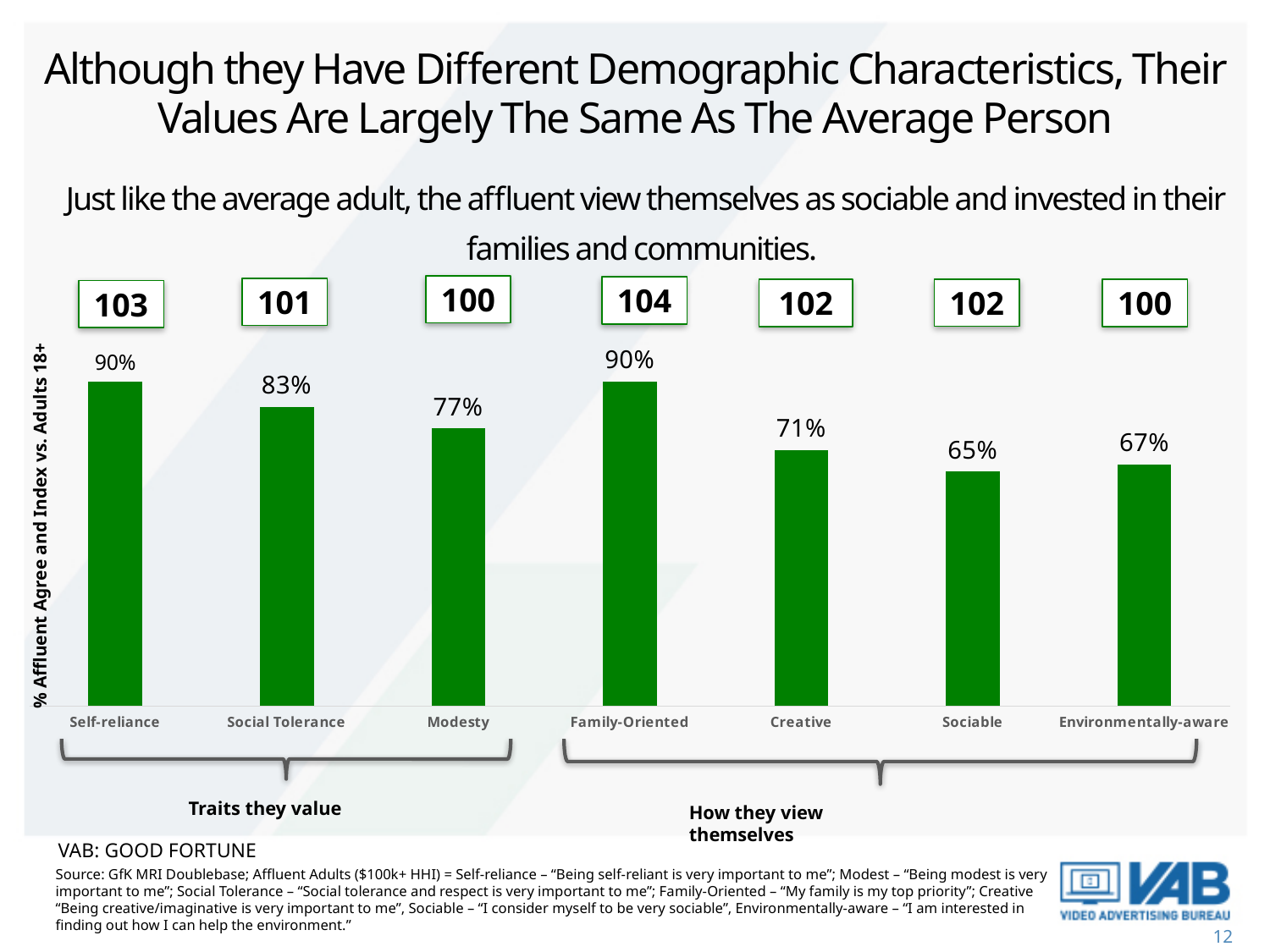
What percentage of affluent adults agree with the Self-reliance statement? 90% Which category has the lowest percentage of affluent adults agreeing? Sociable What is the value shown for Environmentally-aware? 67% What is the value shown for Creative? 71% What kind of chart is shown on the slide? Bar chart Which is larger, the value for Environmentally-aware or the value for Sociable? Environmentally-aware What is the difference between the values for Self-reliance and Social Tolerance? 7% What is the difference between the values for Family-Oriented and Creative? 19% What index value vs. Adults 18+ is shown above the Family-Oriented bar? 104 What is the value shown for Modesty? 77% How many categories are plotted in the chart? 7 What is the value shown for Social Tolerance? 83%